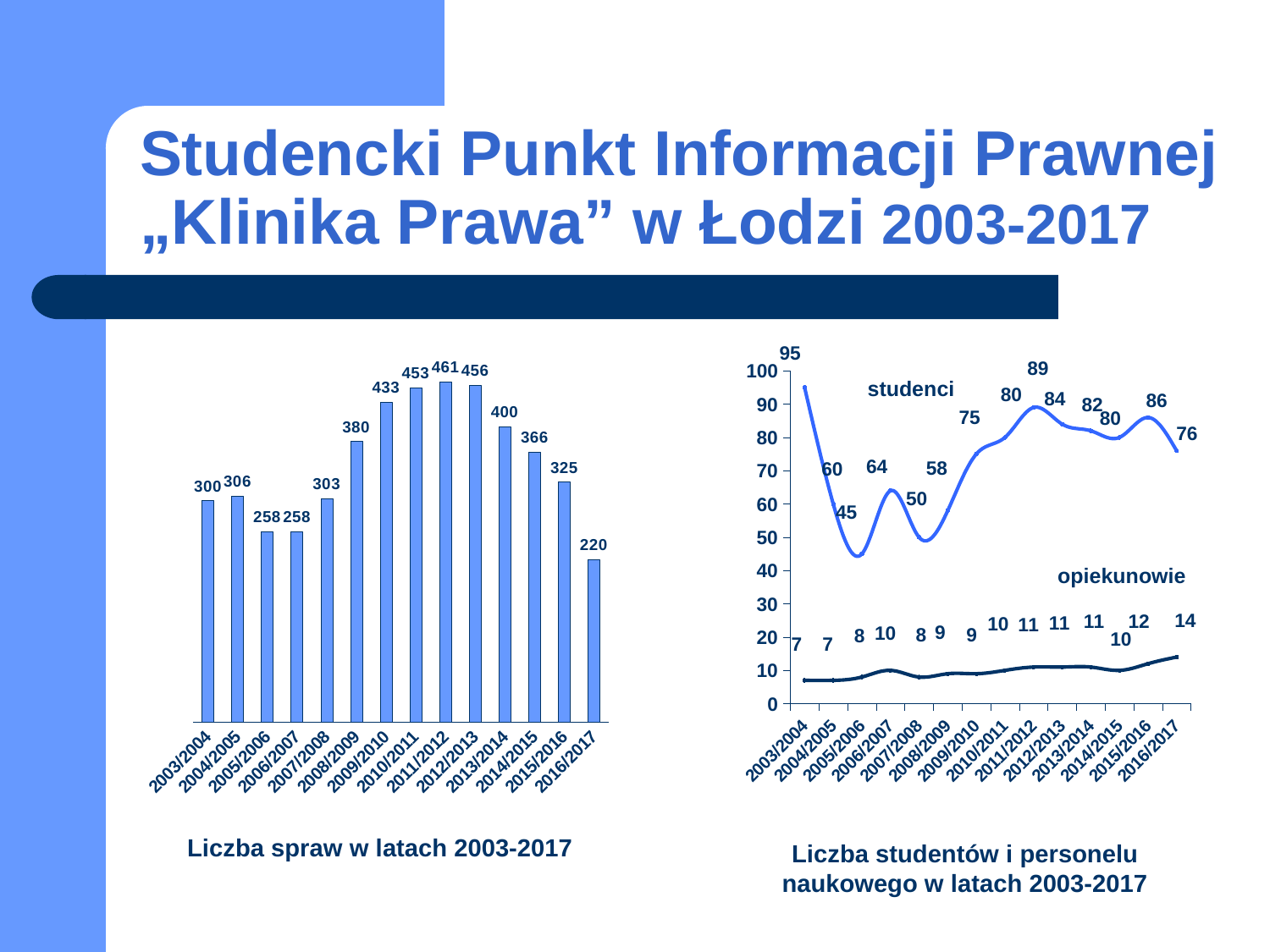
In the right chart 'Liczba studentów i personelu naukowego w latach 2003-2017', what is the value for studenci in 2003/2004? 95 What kind of chart is the right chart 'Liczba studentów i personelu naukowego w latach 2003-2017'? Line chart In the left chart 'Liczba spraw w latach 2003-2017', how many years are shown? 14 In the left chart 'Liczba spraw w latach 2003-2017', which year has the lowest value? 2016/2017 In the left chart 'Liczba spraw w latach 2003-2017', what is the value for 2016/2017? 220 In the right chart 'Liczba studentów i personelu naukowego w latach 2003-2017', which is larger: studenci in 2011/2012 or studenci in 2015/2016? 2011/2012 In the left chart 'Liczba spraw w latach 2003-2017', what is the difference between the values for 2009/2010 and 2008/2009? 53 In the left chart 'Liczba spraw w latach 2003-2017', what is the value for 2011/2012? 461 In the right chart 'Liczba studentów i personelu naukowego w latach 2003-2017', which year has the lowest value for studenci? 2005/2006 In the right chart 'Liczba studentów i personelu naukowego w latach 2003-2017', what is the value for opiekunowie in 2016/2017? 14 What kind of chart is the left chart 'Liczba spraw w latach 2003-2017'? Bar chart In the left chart 'Liczba spraw w latach 2003-2017', which year has the highest value? 2011/2012